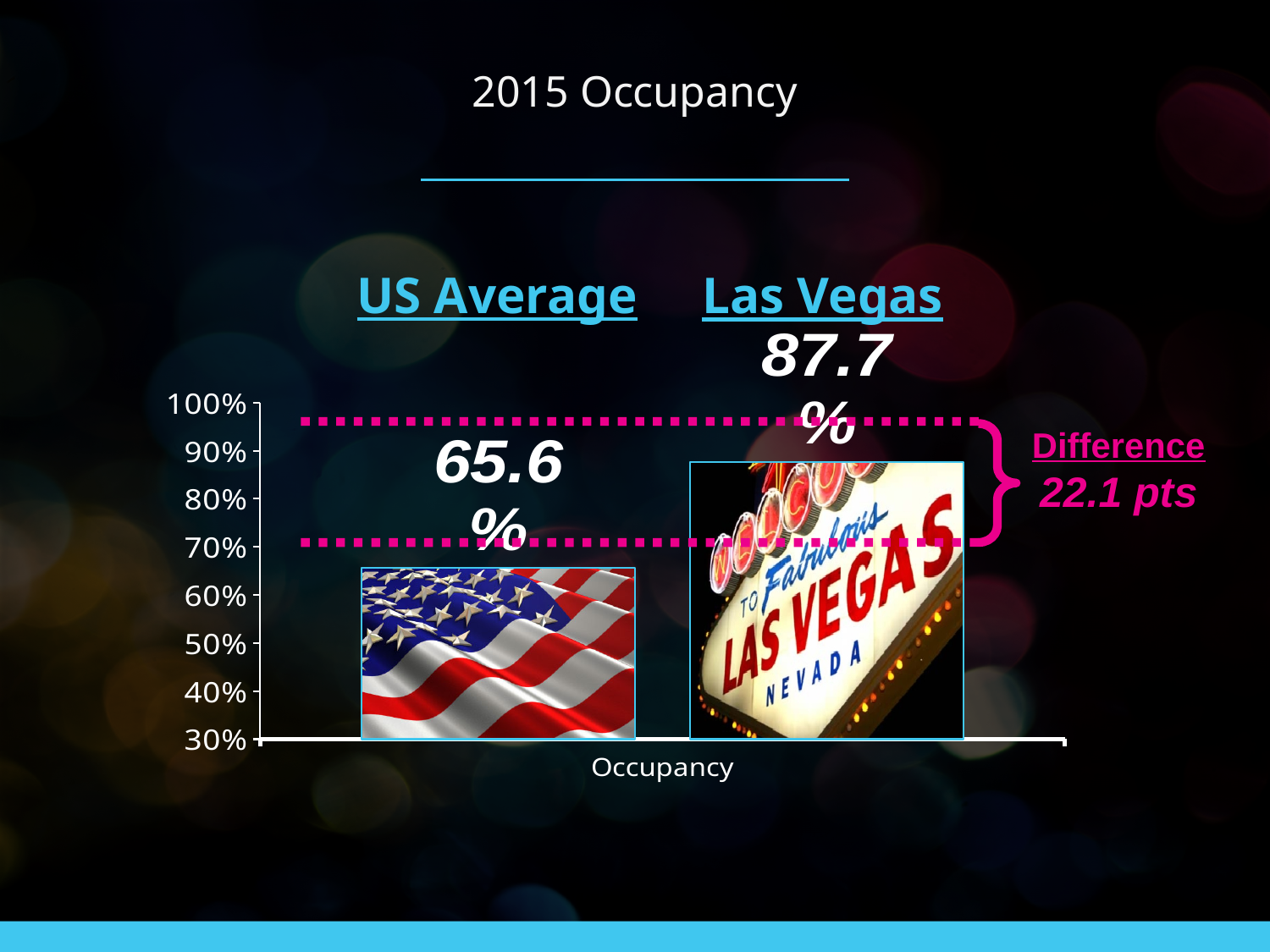
What kind of chart is shown on the slide? Bar chart Which category has the highest occupancy on the chart? Las Vegas Which has the higher occupancy, the US Average or Las Vegas? Las Vegas What is the title of the slide's chart? 2015 Occupancy What is the 2015 occupancy value shown for the US Average? 65.6% What is the lowest value shown on the chart's vertical axis? 30% Is the occupancy value for Las Vegas greater or less than 80%? greater What is the 2015 occupancy value shown for Las Vegas? 87.7% Which category has the lowest occupancy on the chart? US Average How many categories (bars) are plotted on the chart? 2 What is the difference in occupancy between Las Vegas and the US Average, as shown on the slide? 22.1 pts Is the occupancy value for the US Average greater or less than 70%? less